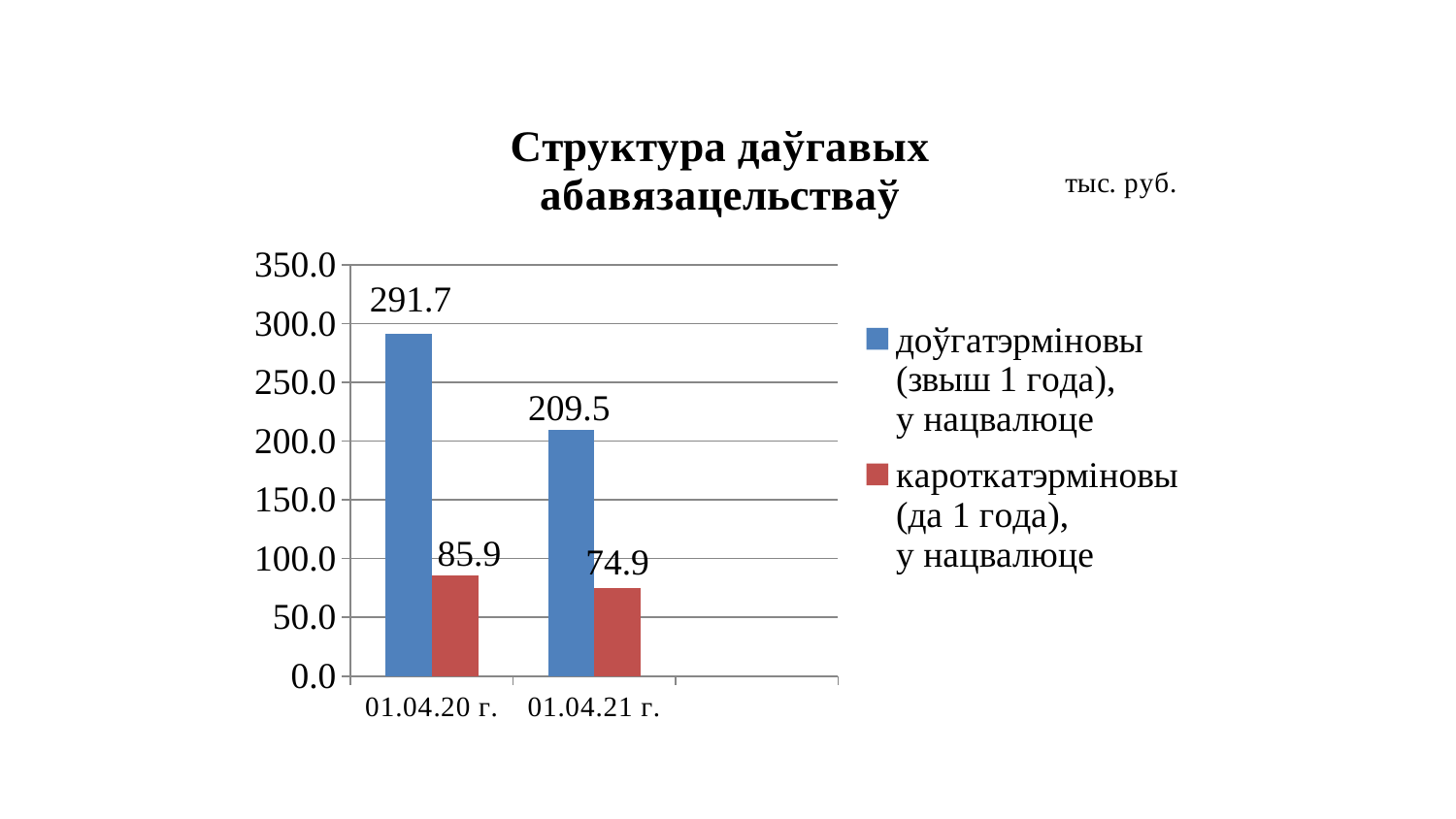
How many series does the legend list? 2 What is the value of the short-term (кароткатэрміновы) series for 01.04.21 г.? 74.9 What is the difference between the long-term and short-term values for 01.04.21 г.? 134.6 By how much did the long-term (доўгатэрміновы) value change from 01.04.20 г. to 01.04.21 г.? 82.2 What type of chart is shown on the slide? bar chart Which date has the lowest short-term (кароткатэрміновы) value? 01.04.21 г. Which is larger for 01.04.20 г.: the long-term or the short-term value? long-term (доўгатэрміновы) What is the value of the long-term (доўгатэрміновы) series for 01.04.21 г.? 209.5 What is the value of the short-term (кароткатэрміновы) series for 01.04.20 г.? 85.9 How many dates (categories) are shown on the x axis? 2 Which date has the highest long-term (доўгатэрміновы) value? 01.04.20 г. What is the value of the long-term (доўгатэрміновы) series for 01.04.20 г.? 291.7